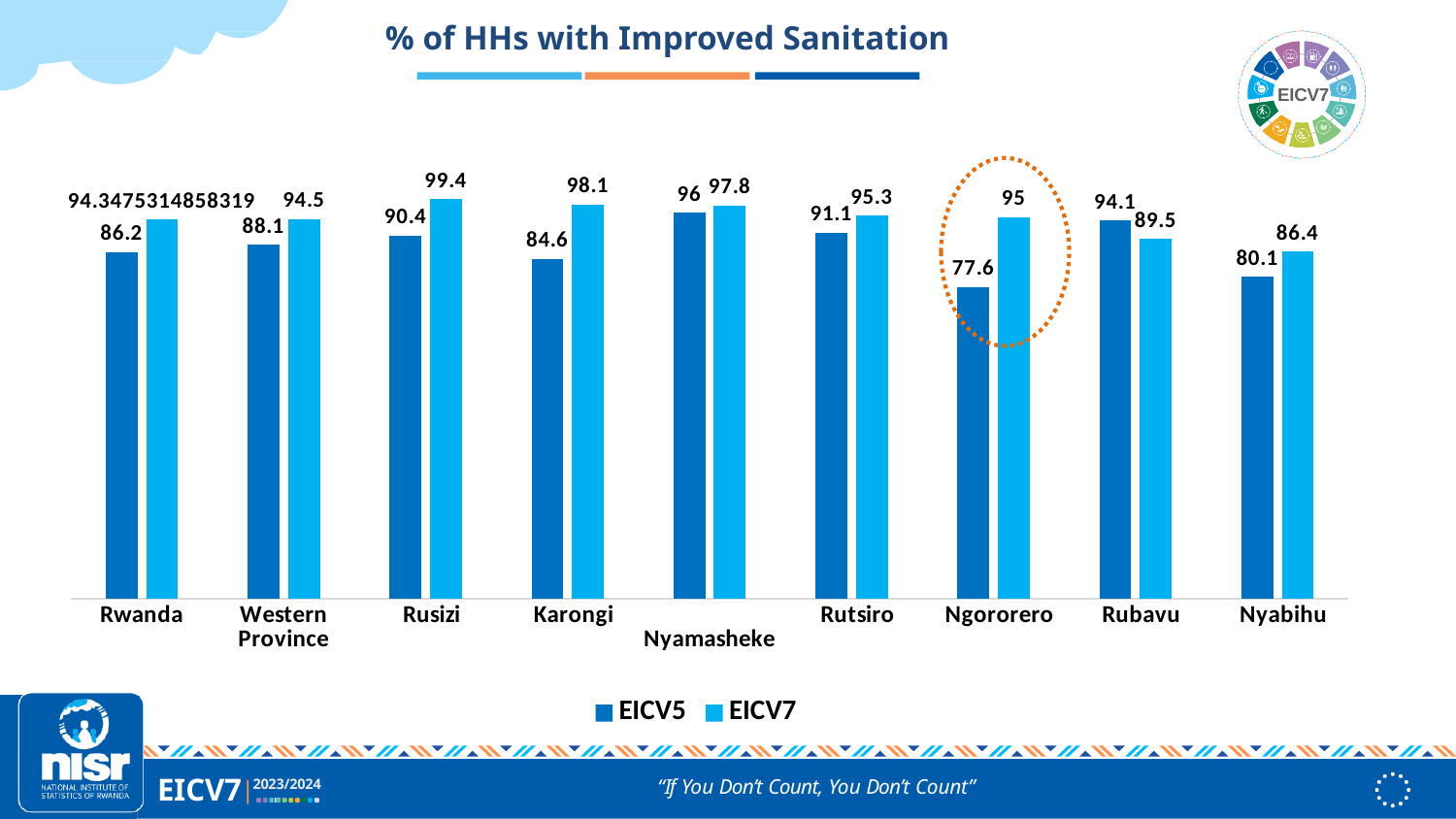
How many series does the legend list? 2 Which category has the highest EICV7 value? Rusizi What type of chart is shown on the slide? Bar chart Which category has the lowest EICV7 value? Nyabihu Which category has the lowest EICV5 value? Ngororero How many categories are shown on the x axis? 9 What is the EICV5 value for Nyamasheke? 96 What is the difference between the EICV7 and EICV5 values for Ngororero? 17.4 For Rubavu, which is larger: the EICV5 value or the EICV7 value? EICV5 What is the EICV5 value for Ngororero? 77.6 What is the title of the chart? % of HHs with Improved Sanitation What is the EICV7 value for Karongi? 98.1